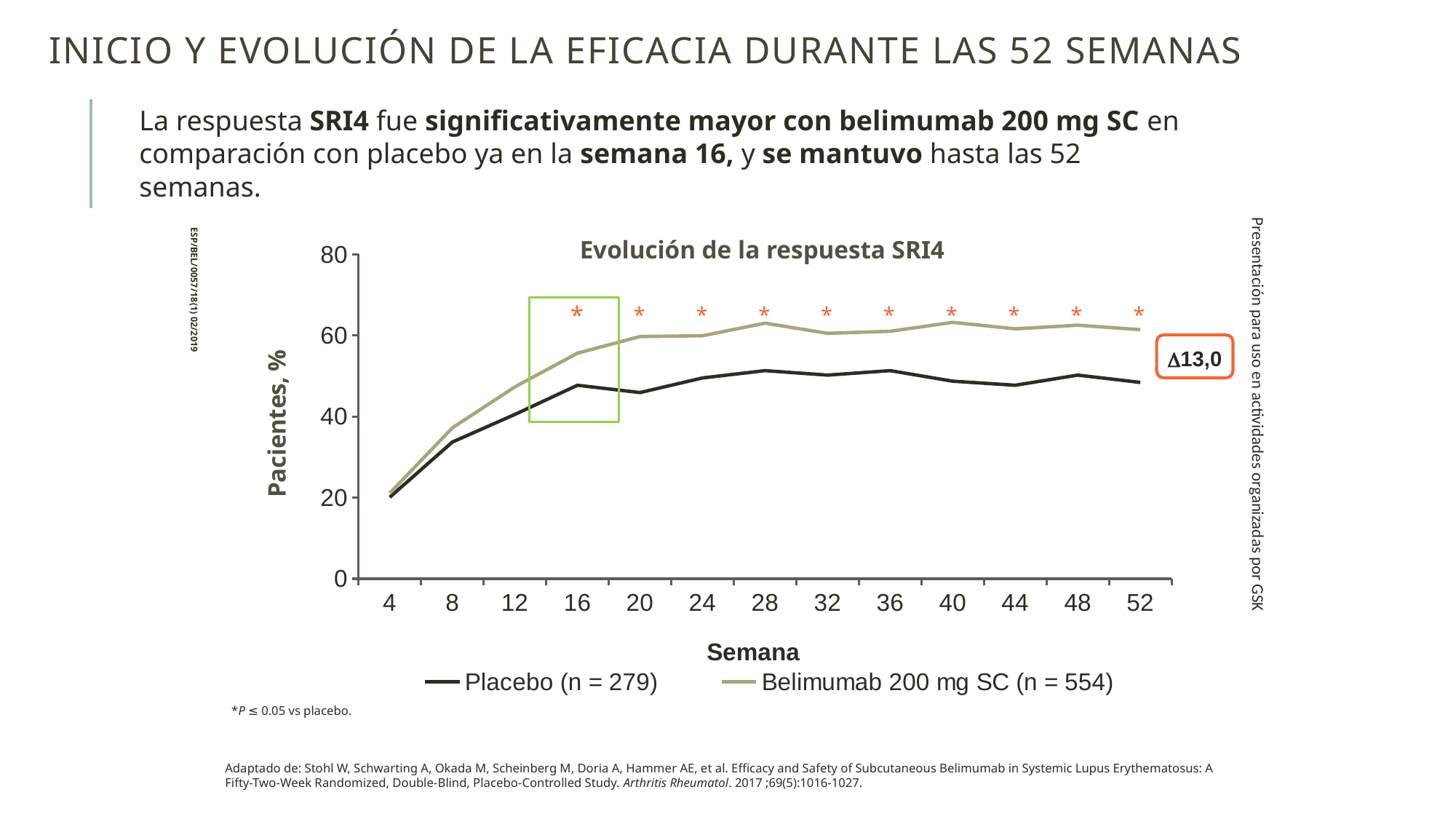
What kind of chart is shown on the slide? line chart How many week points are plotted along the x axis? 13 How many series does the legend list? 2 Is the value for Belimumab 200 mg SC at week 16 greater or less than 40? greater What is the label of the y axis? Pacientes, % What is the title of the chart? Evolución de la respuesta SRI4 At week 52, which series has the higher value, Placebo or Belimumab 200 mg SC? Belimumab 200 mg SC At which week is the Placebo series at its lowest value? 4 At week 16, which series has the higher value, Placebo or Belimumab 200 mg SC? Belimumab 200 mg SC Does the Belimumab 200 mg SC series rise or fall between week 4 and week 20? rise Is the value for Placebo at week 52 greater or less than 60? less Is the value for Placebo at week 8 greater or less than 40? less